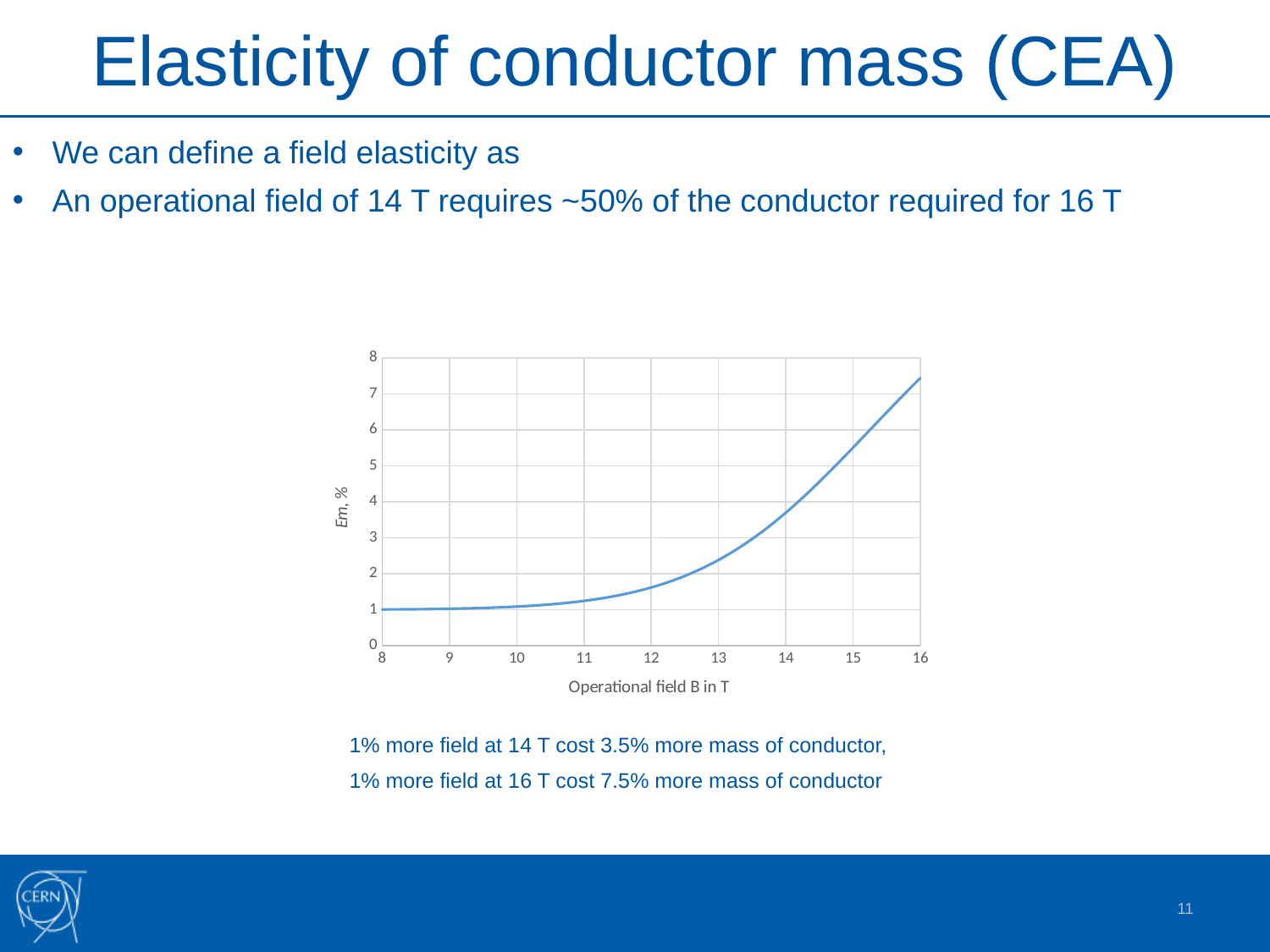
Is the value of Em at 12 T greater or less than 2? less Is the value of Em at 10 T greater or less than 2? less Is the value of Em at 15 T greater or less than 4? greater At which operational field on the x axis is Em highest? 16 Does Em rise or fall as the operational field increases from 8 T to 16 T? rise What is the title of the x axis of the chart? Operational field B in T Which has the larger Em value, 13 T or 15 T? 15 T What is the title of the y axis of the chart? Em, % At which operational field on the x axis is Em lowest? 8 What kind of chart is shown on the slide? line chart